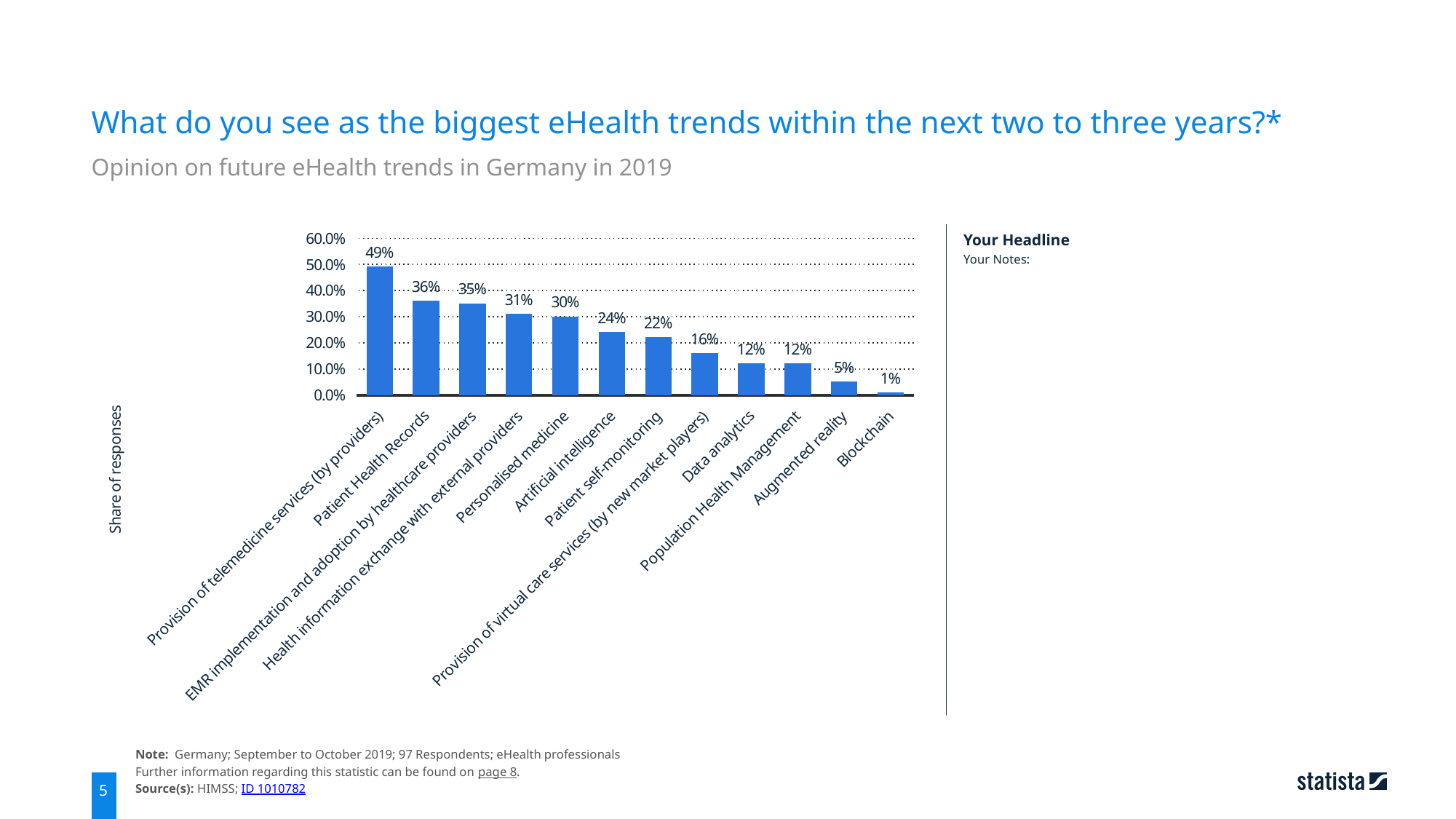
What kind of chart is shown on the slide? Bar chart Which category has the lowest share of responses? Blockchain What is the value shown for Augmented reality? 5% Which category has the highest share of responses? Provision of telemedicine services (by providers) What is the difference between the values for Patient Health Records and Personalised medicine? 6% Do the values rise or fall from left to right along the x axis? Fall Which has a larger value, Patient self-monitoring or Data analytics? Patient self-monitoring What is the value shown for Artificial intelligence? 24% How many categories are shown in the chart? 12 What share of responses named Provision of telemedicine services (by providers) as a biggest eHealth trend? 49% Is the value for Health information exchange with external providers greater or less than 20.0%? greater What is the label on the vertical axis of the chart? Share of responses